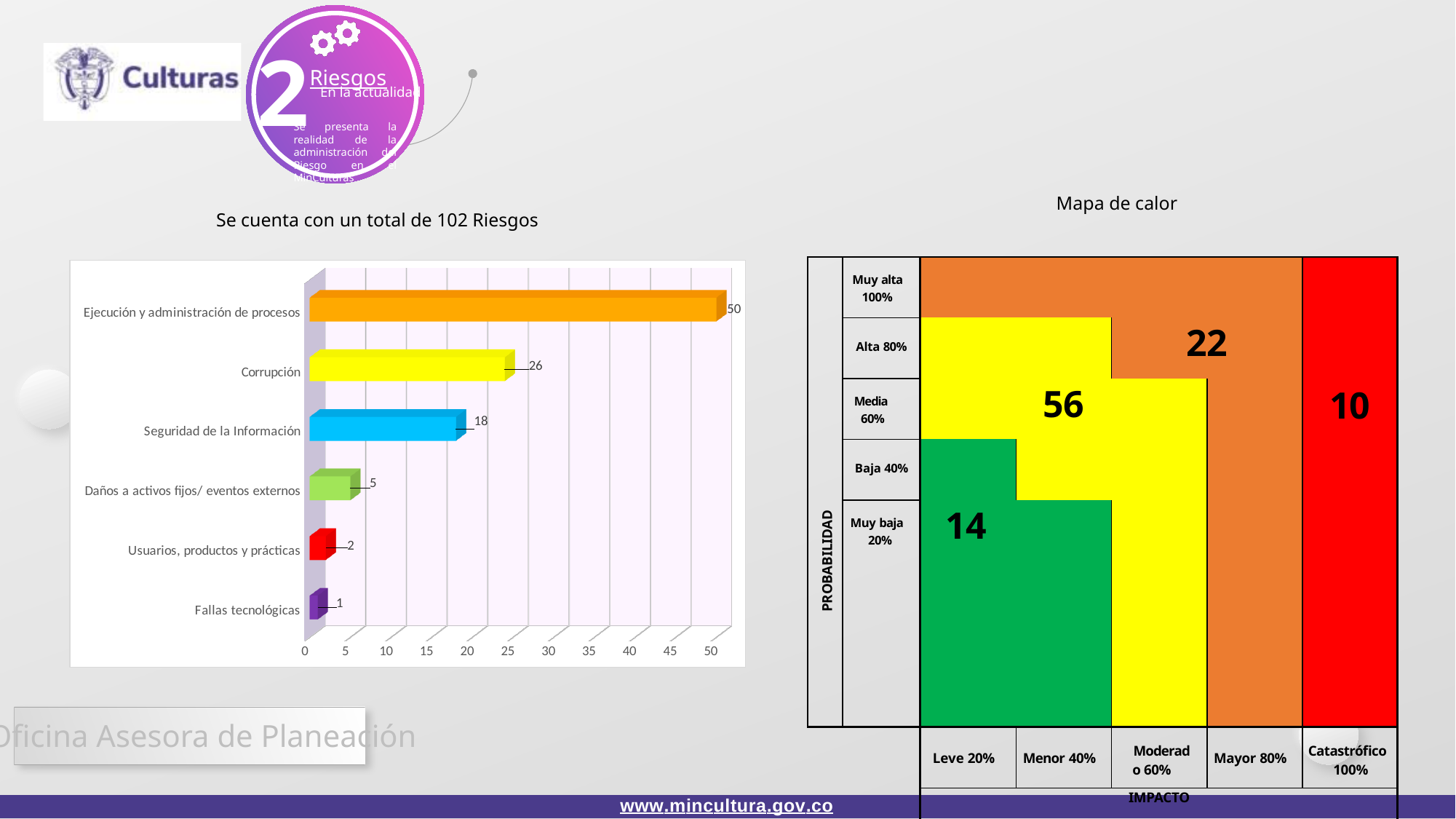
In the bar chart on the left, which category has the lowest value? Fallas tecnológicas In the bar chart on the left, what is the difference between the values for Ejecución y administración de procesos and Corrupción? 24 In the bar chart on the left, what is the difference between the values for Usuarios, productos y prácticas and Fallas tecnológicas? 1 In the bar chart on the left, what is the value for Daños a activos fijos/ eventos externos? 5 In the bar chart on the left, which is larger: the value for Seguridad de la Información or the value for Corrupción? Corrupción In the bar chart on the left, what is the value for Seguridad de la Información? 18 In the bar chart on the left, which category has the highest value? Ejecución y administración de procesos In the bar chart on the left, what colour is the bar for Seguridad de la Información? Blue In the bar chart on the left, how many categories are shown? 6 What kind of chart is shown on the left of the slide? Bar chart In the bar chart on the left, what is the value for Ejecución y administración de procesos? 50 In the bar chart on the left, what is the value for Corrupción? 26